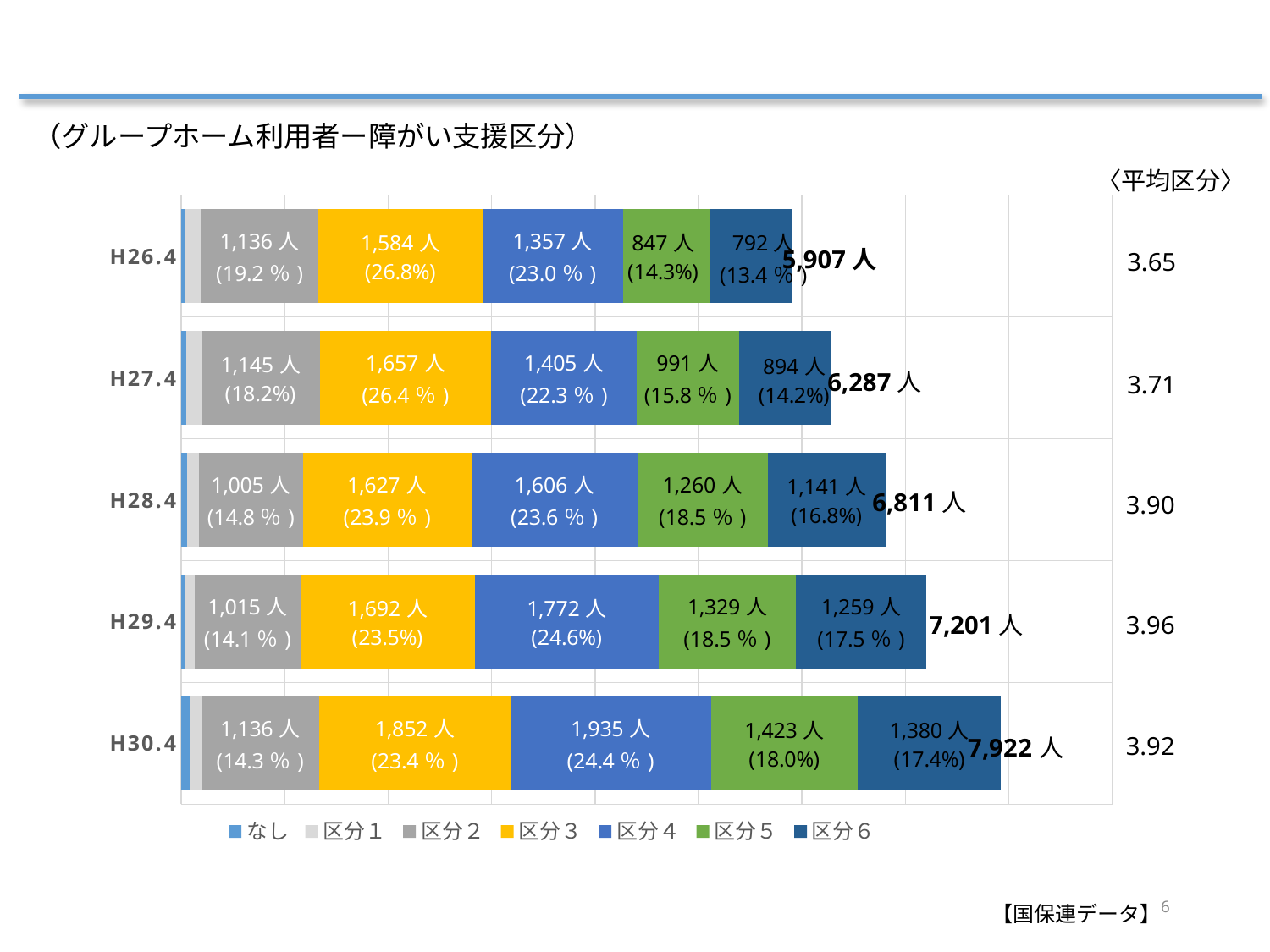
What is the value for 区分3 in the H30.4 bar? 1,852人 What is the value for 区分6 in the H26.4 bar? 792人 What is the value for 区分4 in the H29.4 bar? 1,772人 In the H29.4 bar, which is larger: 区分3 or 区分4? 区分4 Do the bar totals rise or fall from H26.4 to H30.4? Rise What is the difference between the 区分5 value for H30.4 and the 区分5 value for H26.4? 576人 Which period has the highest total number of users? H30.4 What type of chart is shown on the slide? Stacked bar chart What is the total shown for the H28.4 bar? 6,811人 How many series does the legend list? 7 How many bars (time periods) are plotted in the chart? 5 What percentage share does 区分2 have in the H26.4 bar? 19.2%